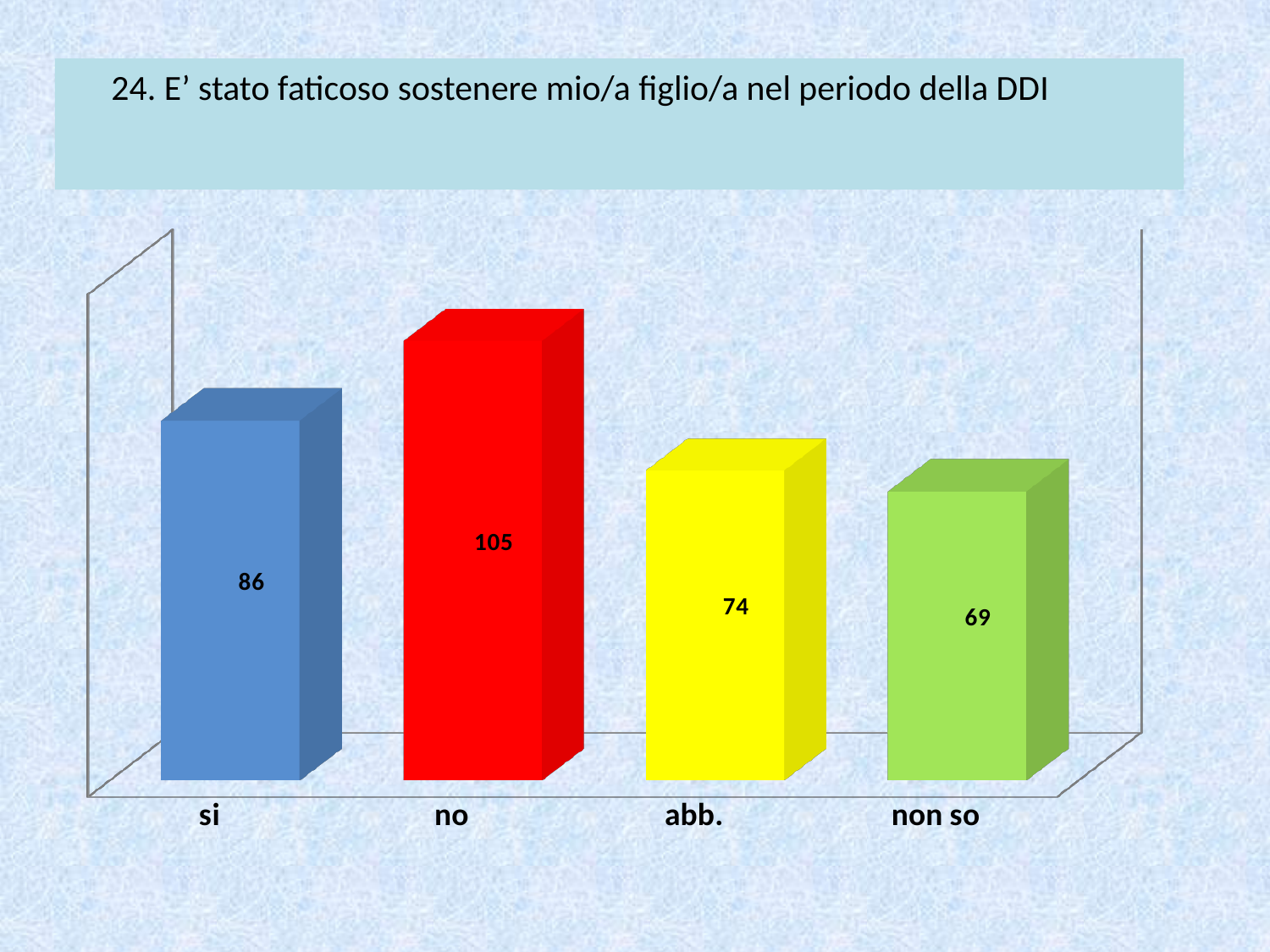
Which category has the lowest value? non so What is the value for "non so"? 69 What is the value for "no"? 105 Which is larger, the value for "si" or the value for "abb."? si Which category has the highest value? no How many categories are shown in the chart? 4 What is the difference between the values for "no" and "si"? 19 What is the value for "si"? 86 What kind of chart is shown on the slide? bar chart What is the difference between the values for "abb." and "non so"? 5 What colour is the bar for "no"? red What is the value for "abb."? 74